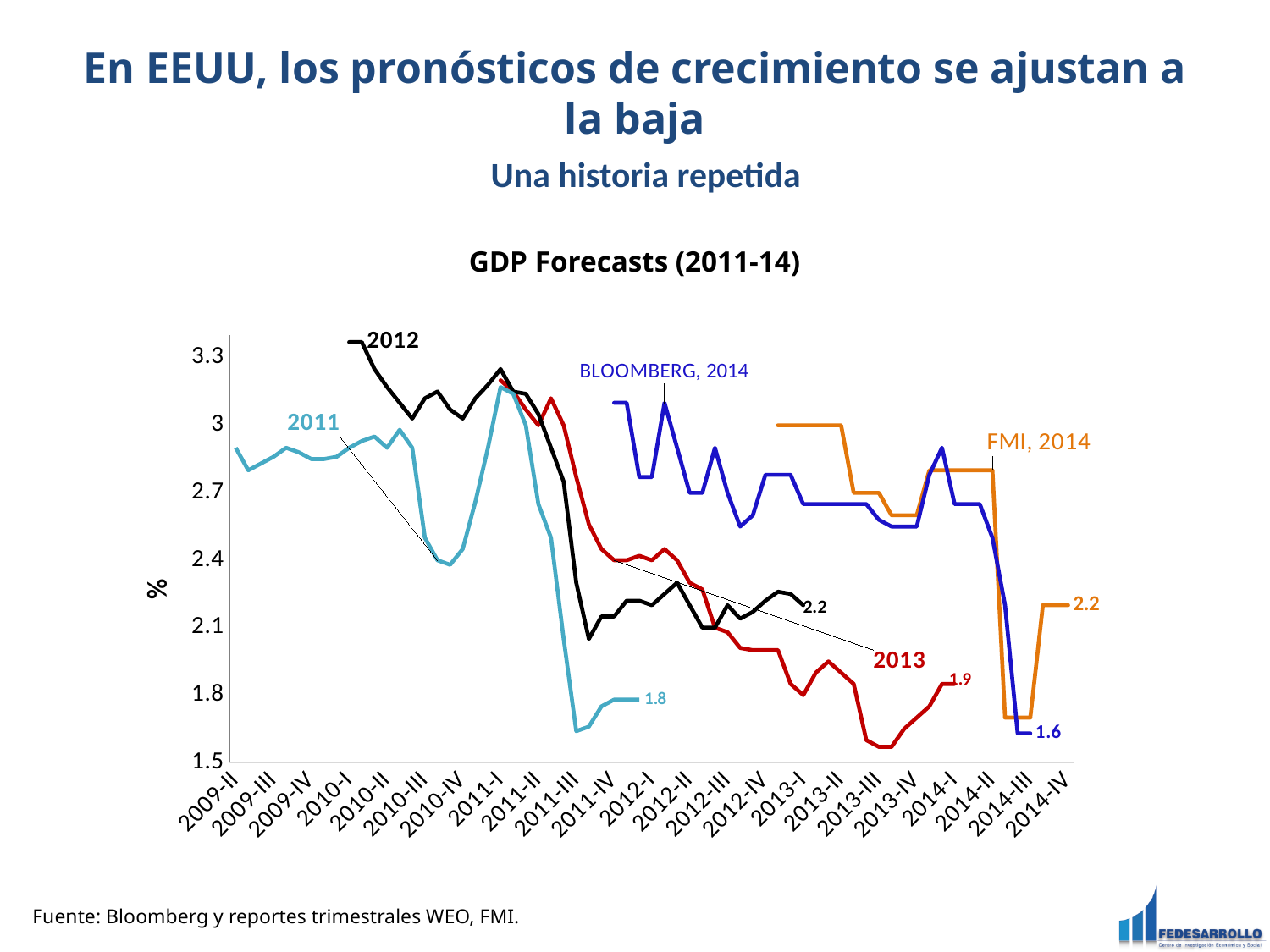
Is the value of the FMI, 2014 series at 2013-I greater or less than 2.7? greater What is the title of the chart? GDP Forecasts (2011-14) Which series ends at the lowest labelled value? BLOOMBERG, 2014 How many forecast series are plotted on the chart? 5 What is the final labelled value of the 2011 forecast series? 1.8 What is the final labelled value of the BLOOMBERG, 2014 series? 1.6 What is the final labelled value of the 2013 forecast series? 1.9 What is the final labelled value of the 2012 forecast series? 2.2 What is the final labelled value of the FMI, 2014 series? 2.2 What kind of chart is shown on the slide? line chart Which ends higher, the 2013 forecast series or the 2011 forecast series? 2013 What is the difference between the final labelled values of the FMI, 2014 series and the BLOOMBERG, 2014 series? 0.6